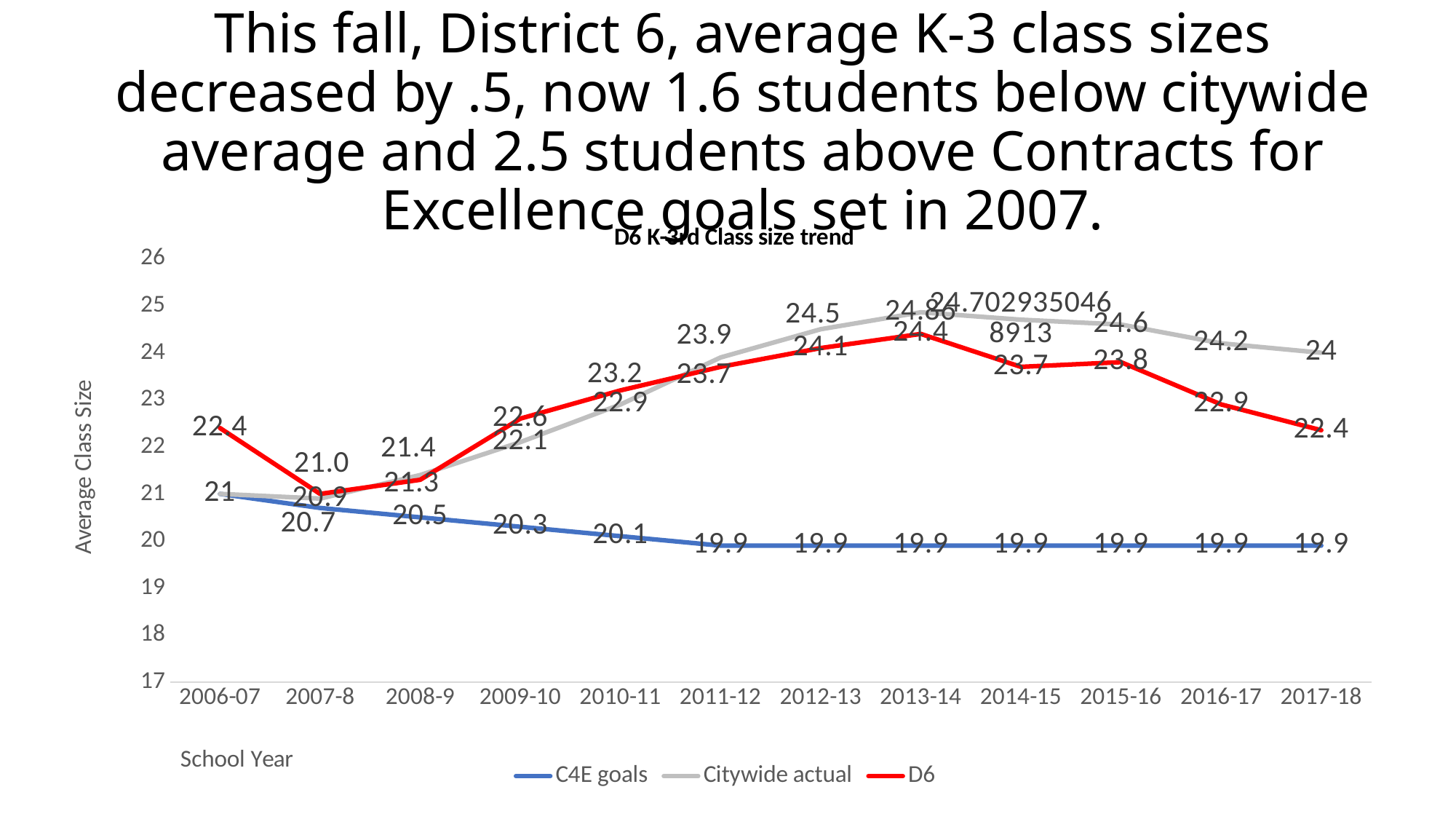
In which school year is the D6 value lowest? 2007-8 How many series does the legend list? 3 What is the Citywide actual value for 2012-13? 24.5 What is the C4E goals value for 2010-11? 20.1 What is the difference between the Citywide actual and D6 values in 2017-18? 1.6 How many school years are shown on the x axis? 12 What kind of chart is shown on the slide? line chart In which school year is the D6 value highest? 2013-14 Does the D6 line rise or fall from 2013-14 to 2017-18? fall What is the D6 average class size for 2017-18? 22.4 What is the Citywide actual value for 2016-17? 24.2 In 2011-12, which is larger: the Citywide actual value or the D6 value? Citywide actual